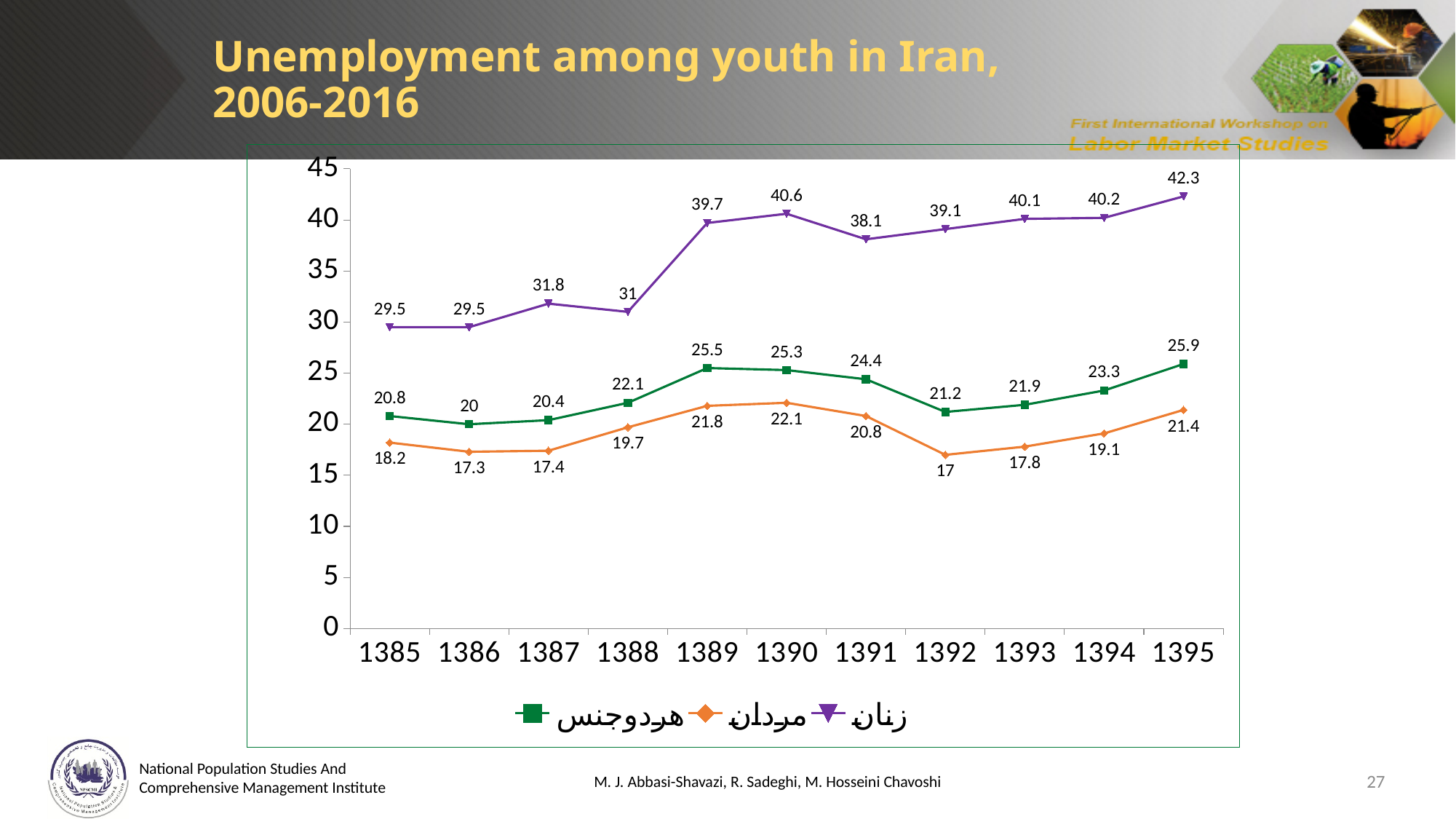
What is the value of the green هردوجنس series in 1389? 25.5 What is the value of the orange مردان series in 1392? 17 In which year is the orange مردان series at its lowest value? 1392 What is the difference between the زنان and مردان values in 1390? 18.5 What is the value of the purple زنان series in 1395? 42.3 In which year does the purple زنان series reach its highest value? 1395 Is the value of the purple زنان series in 1387 greater or less than 30? greater What kind of chart is shown on the slide? line chart Which series has the higher value in 1388, زنان or هردوجنس? زنان How many years are shown on the x axis? 11 Does the purple زنان series rise or fall between 1388 and 1389? rise How many series does the legend list? 3